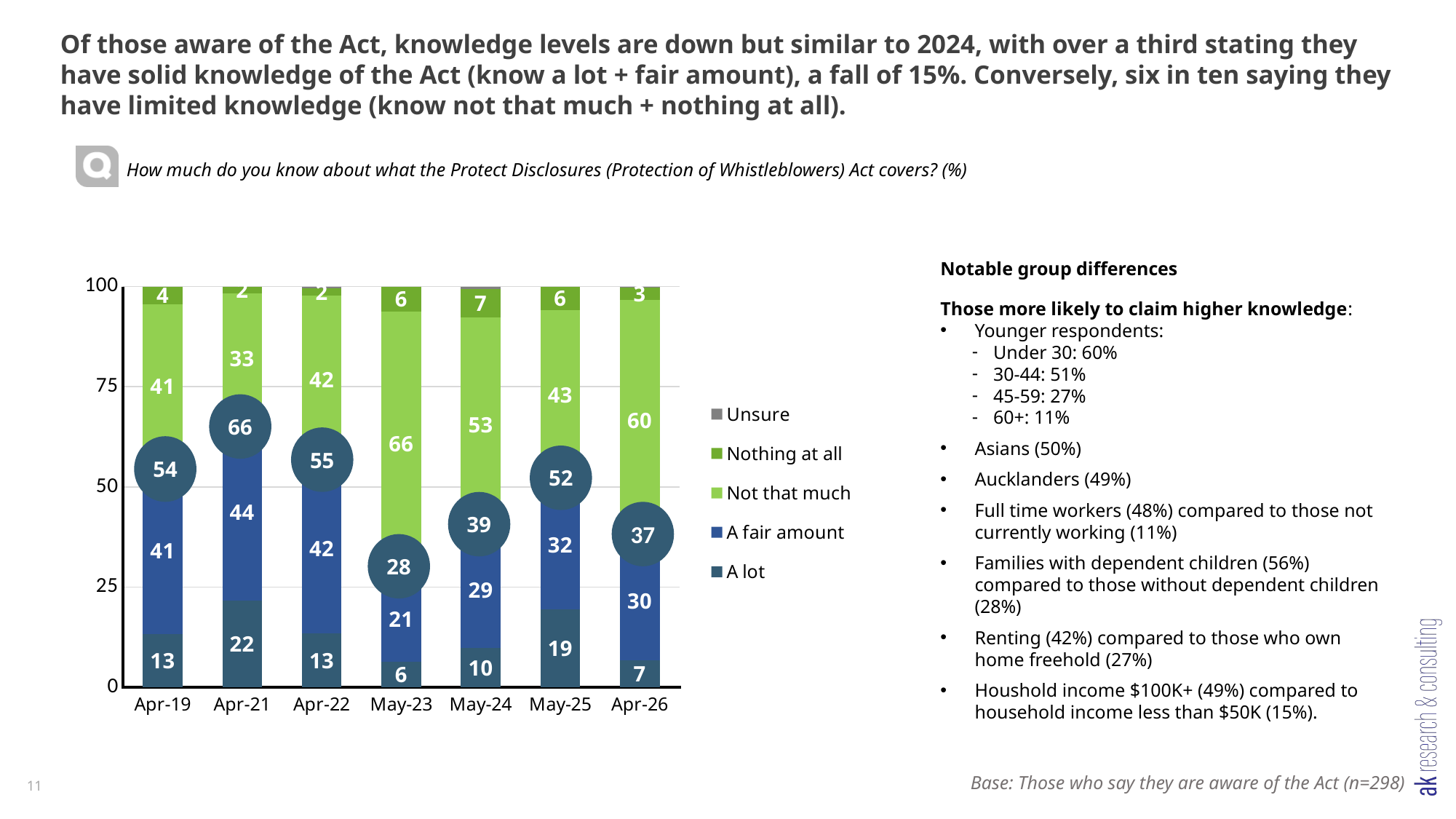
In which period is the "Nothing at all" value highest? May-24 What is the value for "A lot" in Apr-26? 7 What is the value for "A fair amount" in May-25? 32 In which period is the "A lot" value highest? Apr-21 How many time periods are shown on the x axis? 7 Which is larger, the "A fair amount" value for Apr-21 or for Apr-26? Apr-21 In which period is the "A lot" value lowest? May-23 How many series does the legend list? 5 What is the difference between the "Not that much" values for Apr-26 and May-25? 17 What kind of chart is shown on the slide? Stacked bar chart What combined value is shown in the circle for May-24? 39 What is the value for "Not that much" in May-23? 66